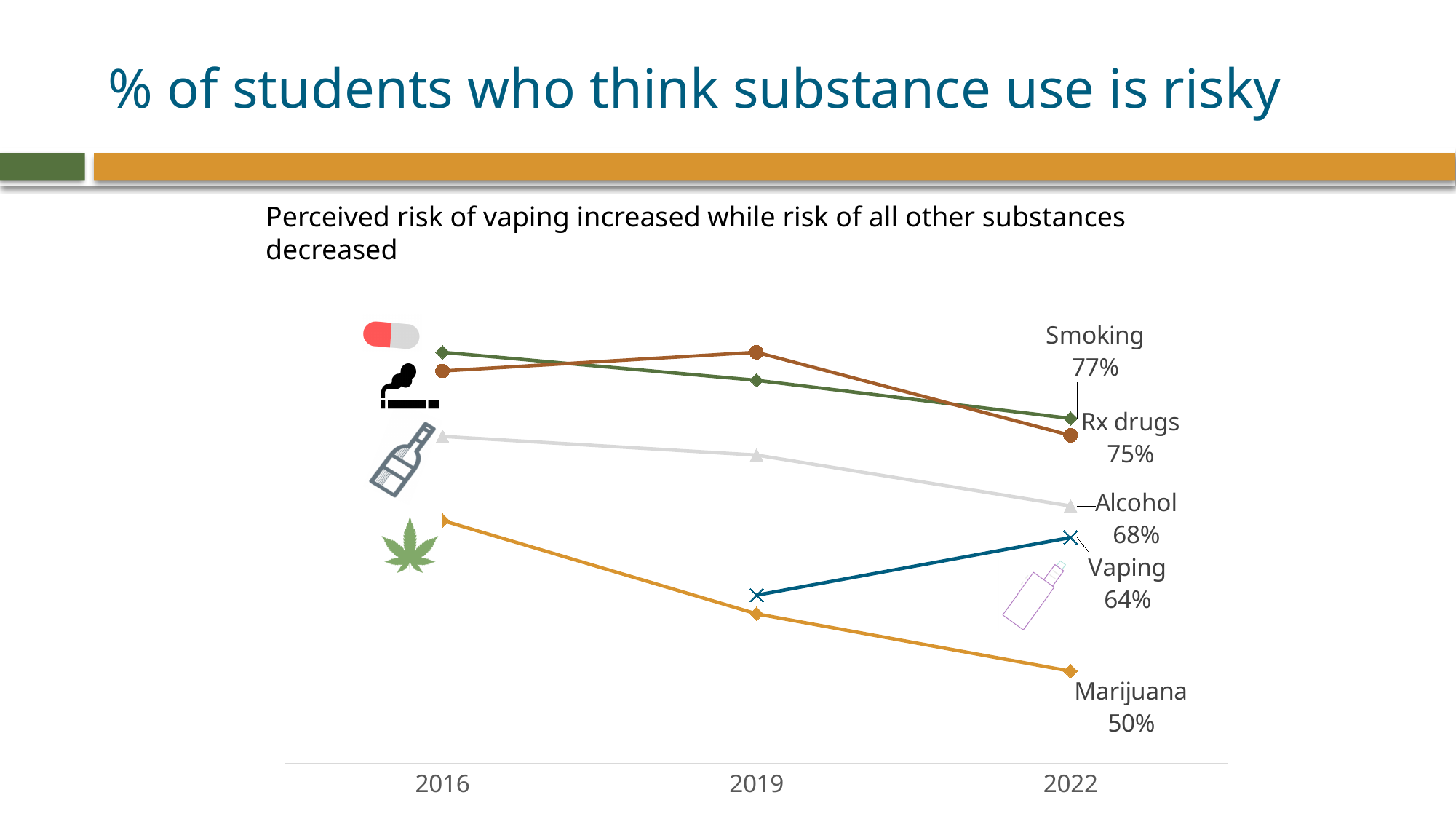
What is the value for Rx drugs in 2022? 75% Which substance has the lowest perceived risk in 2022? Marijuana In 2022, which is larger: the value for Alcohol or the value for Vaping? Alcohol Which substance has the highest perceived risk in 2022? Smoking What percentage of students thought smoking was risky in 2022? 77% What is the value for Vaping in 2022? 64% What kind of chart is shown on the slide? Line chart How many years are shown on the x axis? 3 What is the value for Marijuana in 2022? 50% What is the difference between the Smoking and Marijuana values in 2022? 27 percentage points What is the value for Alcohol in 2022? 68% Does the Vaping line rise or fall from 2019 to 2022? Rises